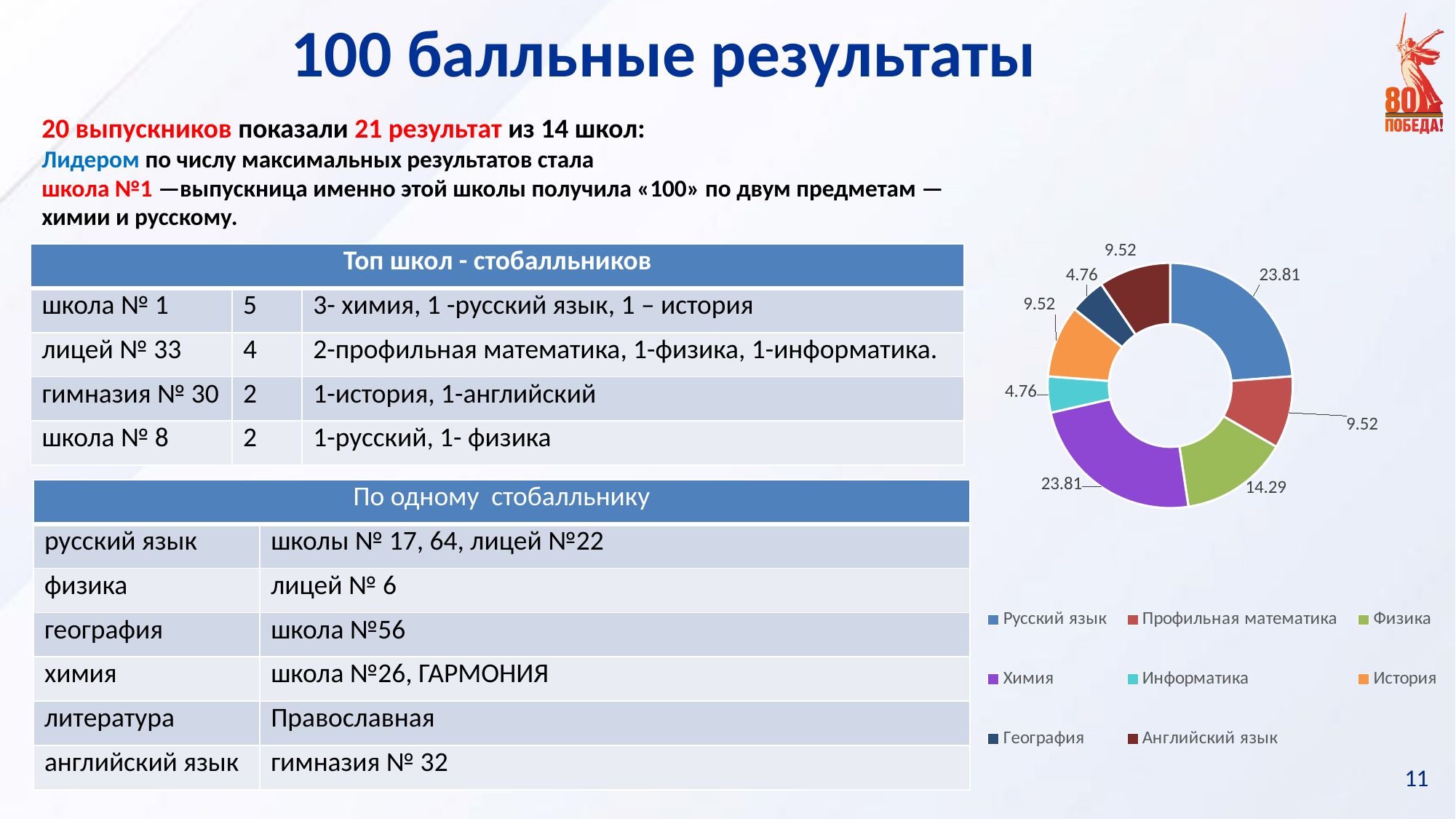
What is the difference between the values for Русский язык and Физика in the doughnut chart? 9.52 What value is shown for Русский язык in the doughnut chart? 23.81 What value is shown for Химия in the doughnut chart? 23.81 Which is larger in the doughnut chart, Химия or География? Химия How many categories does the doughnut chart's legend list? 8 What value is shown for Физика in the doughnut chart? 14.29 What value is shown for История in the doughnut chart? 9.52 What value is shown for Информатика in the doughnut chart? 4.76 Which is larger in the doughnut chart, Физика or Профильная математика? Физика What is the difference between the values for История and Информатика in the doughnut chart? 4.76 What kind of chart is shown on the right of the slide? doughnut (pie) chart Which legend entry in the doughnut chart is shown in purple? Химия